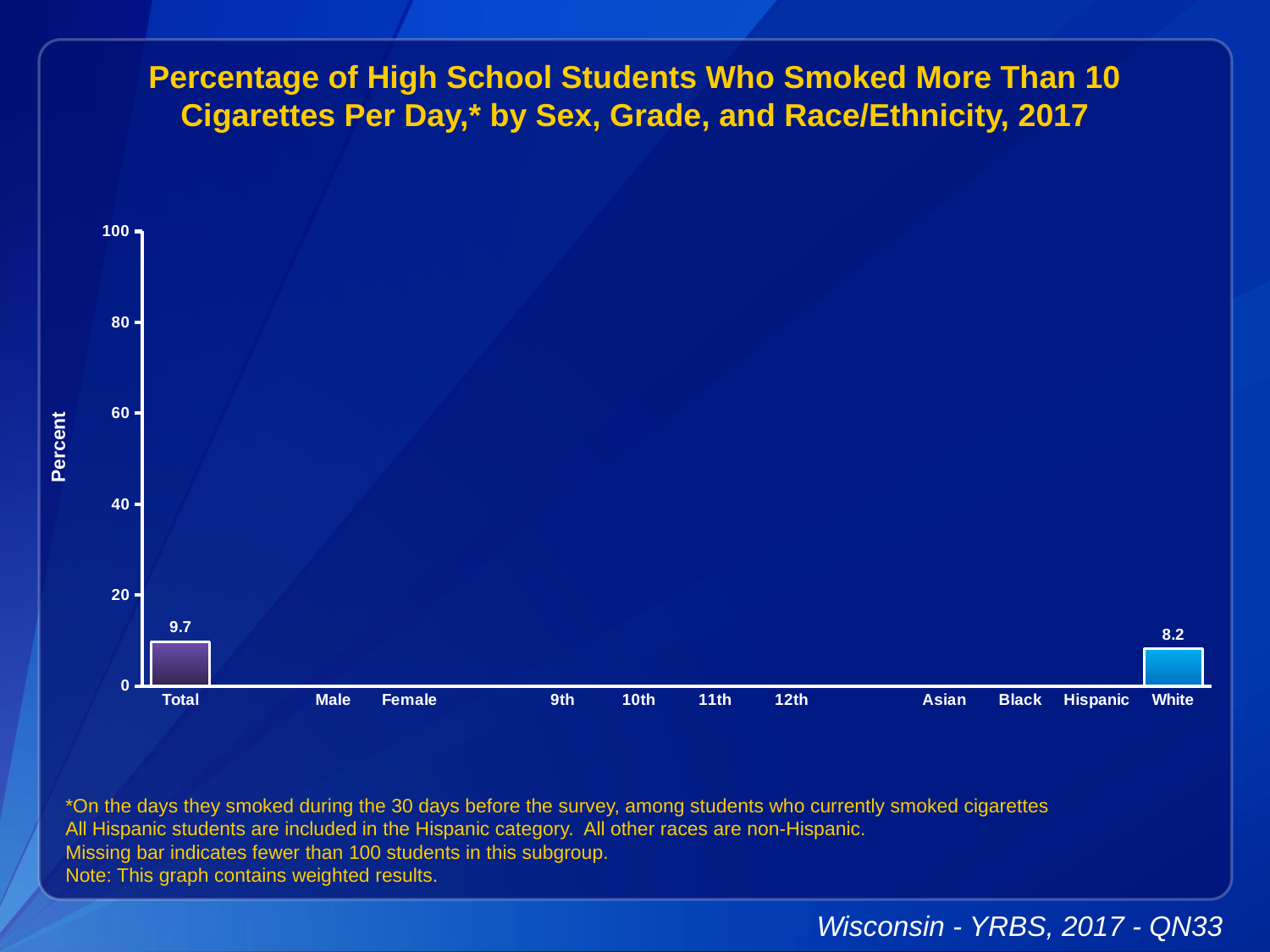
Which of the two plotted bars, Total or White, is larger? Total Which category has the highest plotted value? Total How many category labels are shown on the x axis? 11 What is the value for White? 8.2 What is the label on the y axis? Percent Is the value for Total greater or less than 20? less What is the value for Total? 9.7 Is the value for White greater or less than 20? less What kind of chart is shown on the slide? bar chart What is the maximum value shown on the y axis? 100 What is the difference between the Total value and the White value? 1.5 How many bars are actually plotted on the chart? 2